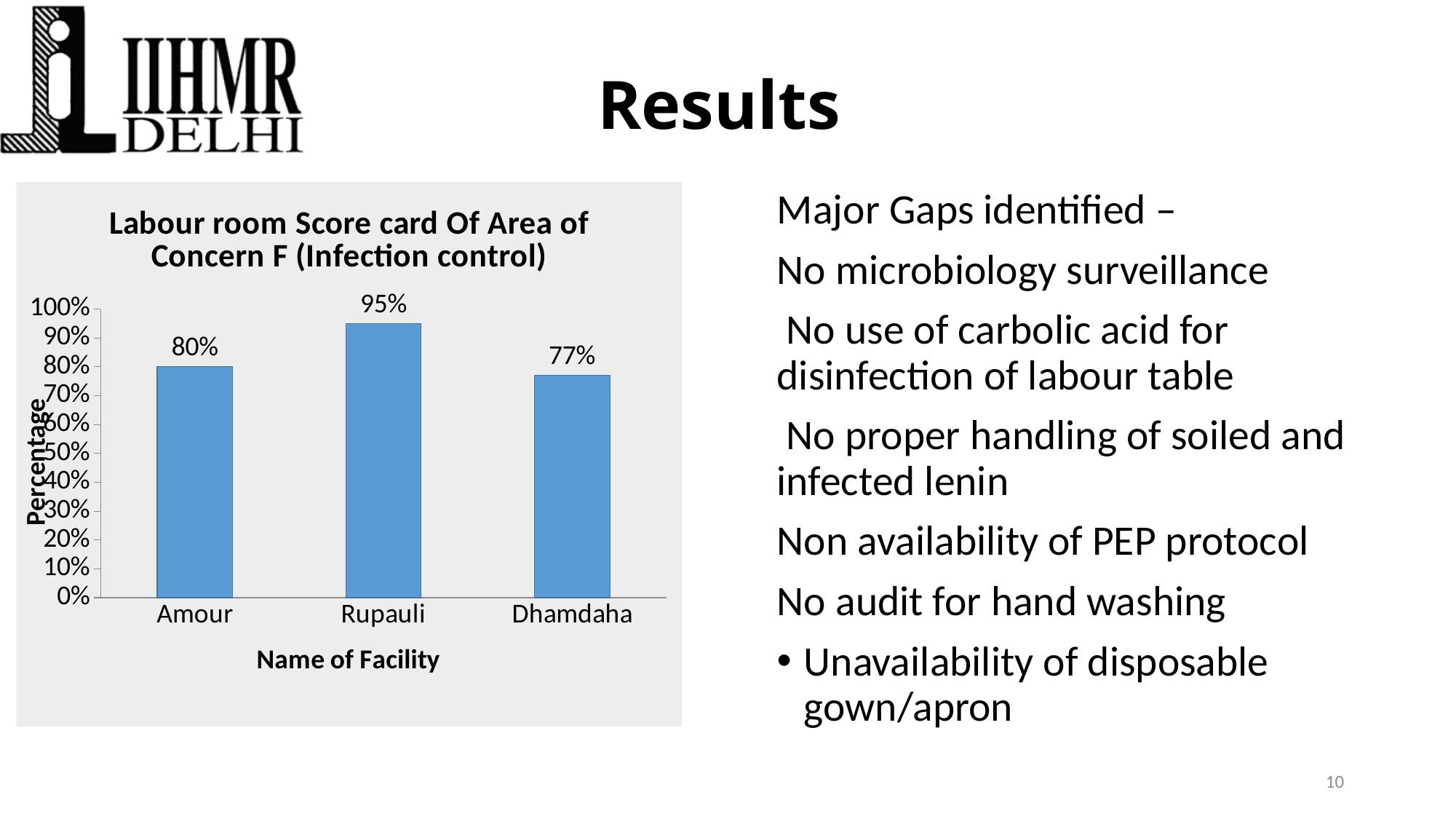
What is the difference between the values for Rupauli and Amour? 15% Which is larger, the value for Rupauli or the value for Dhamdaha? Rupauli What is the value for Rupauli? 95% What kind of chart is shown on the slide? bar chart How many facilities are shown in the chart? 3 What is the title of the chart? Labour room Score card Of Area of Concern F (Infection control) Which facility has the lowest score? Dhamdaha What is the value for Dhamdaha? 77% What is the difference between the values for Amour and Dhamdaha? 3% Which facility has the highest score? Rupauli Is the value for Dhamdaha greater or less than 90%? less What is the value for Amour? 80%